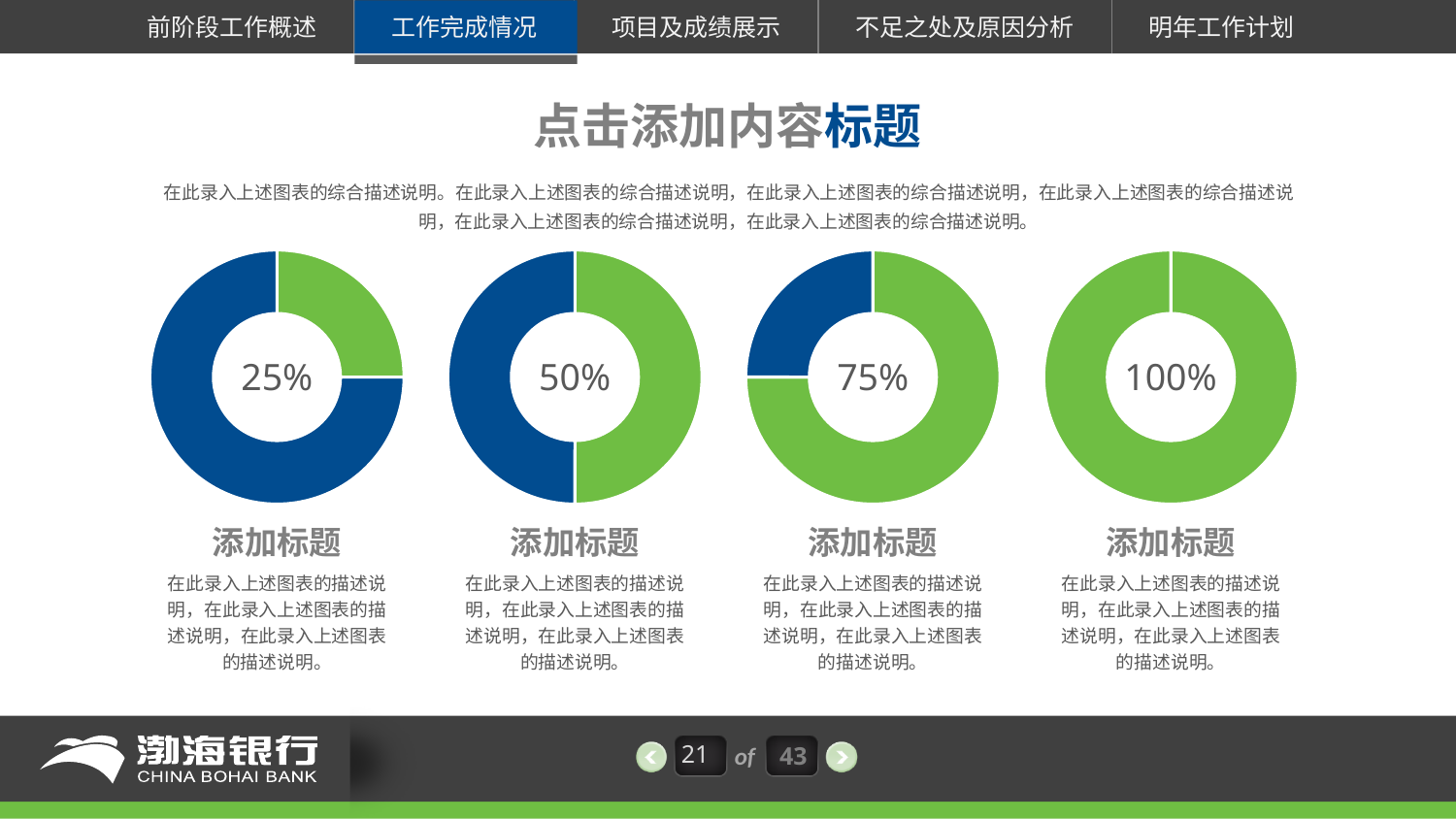
What percentage is shown in the centre of the rightmost donut chart? 100% How many donut charts are on the slide? 4 Which donut chart shows the highest percentage, by position on the slide? the rightmost What percentage is shown in the centre of the leftmost donut chart? 25% What kind of chart is the leftmost chart on the slide? donut chart What percentage is shown in the centre of the third donut chart from the left? 75% In the leftmost donut chart, what share of the ring is filled green? 25% What colour is the filled portion of the rings in the donut charts? green What percentage is shown in the centre of the second donut chart from the left? 50% Which donut chart shows the lowest percentage, by position on the slide? the leftmost What is the difference between the percentage in the third donut chart from the left and the percentage in the leftmost donut chart? 50% Which shows a larger percentage: the second donut chart from the left or the third donut chart from the left? the third from the left